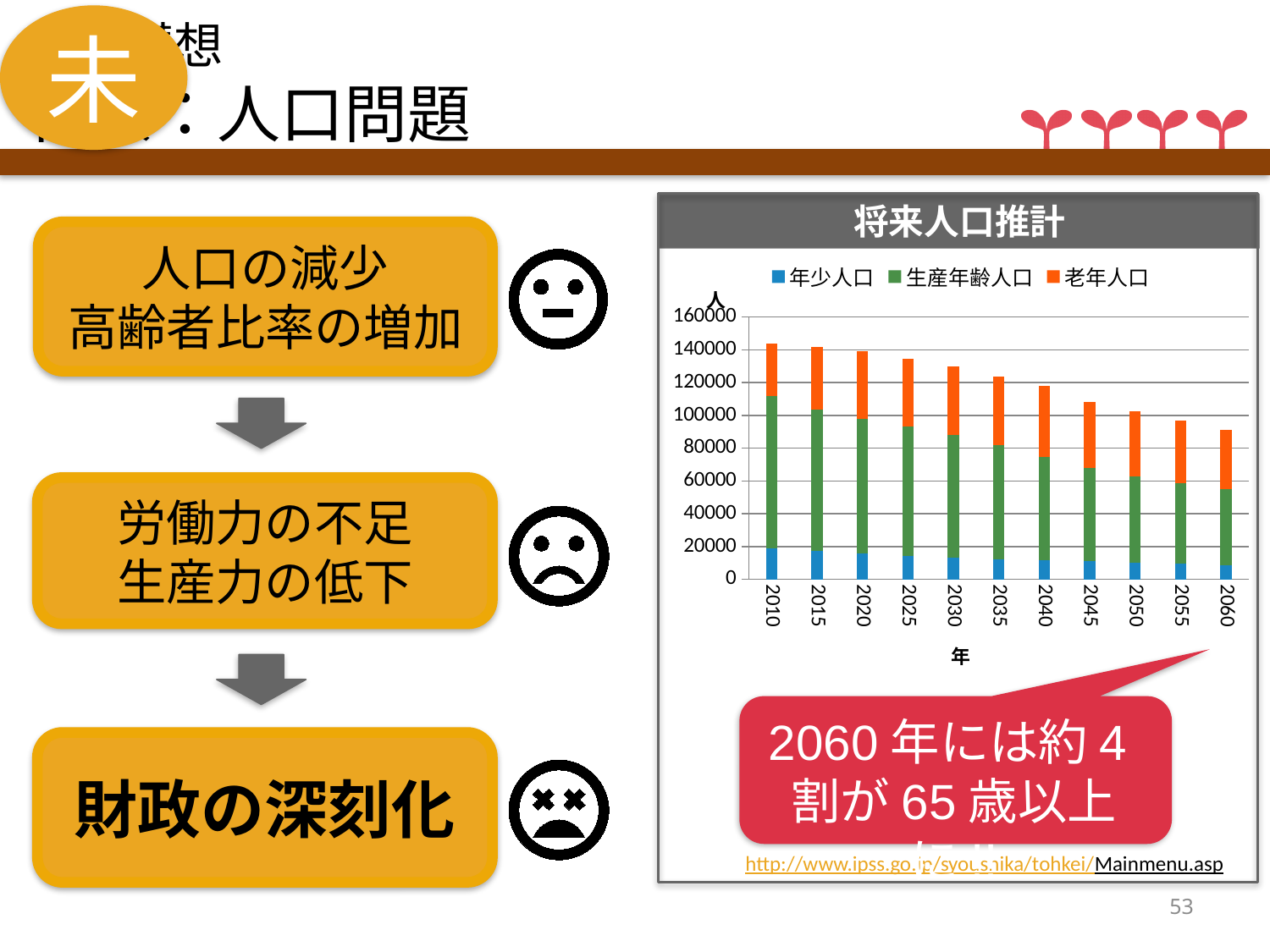
Is the total bar for 2010 greater or less than 120000? greater Which series is shown in orange in the legend? 老年人口 How many years (categories) are plotted along the x axis? 11 How many series does the chart's legend list? 3 Which is larger, the total bar for 2010 or the total bar for 2060? 2010 What is the title of the chart? 将来人口推計 Is the total bar for 2060 greater or less than 100000? less What kind of chart is shown on the slide? stacked bar chart Which year has the shortest total bar? 2060 Is the total bar for 2040 greater or less than 100000? greater Which year has the tallest total bar? 2010 Do the total bar heights rise or fall from 2010 to 2060? fall